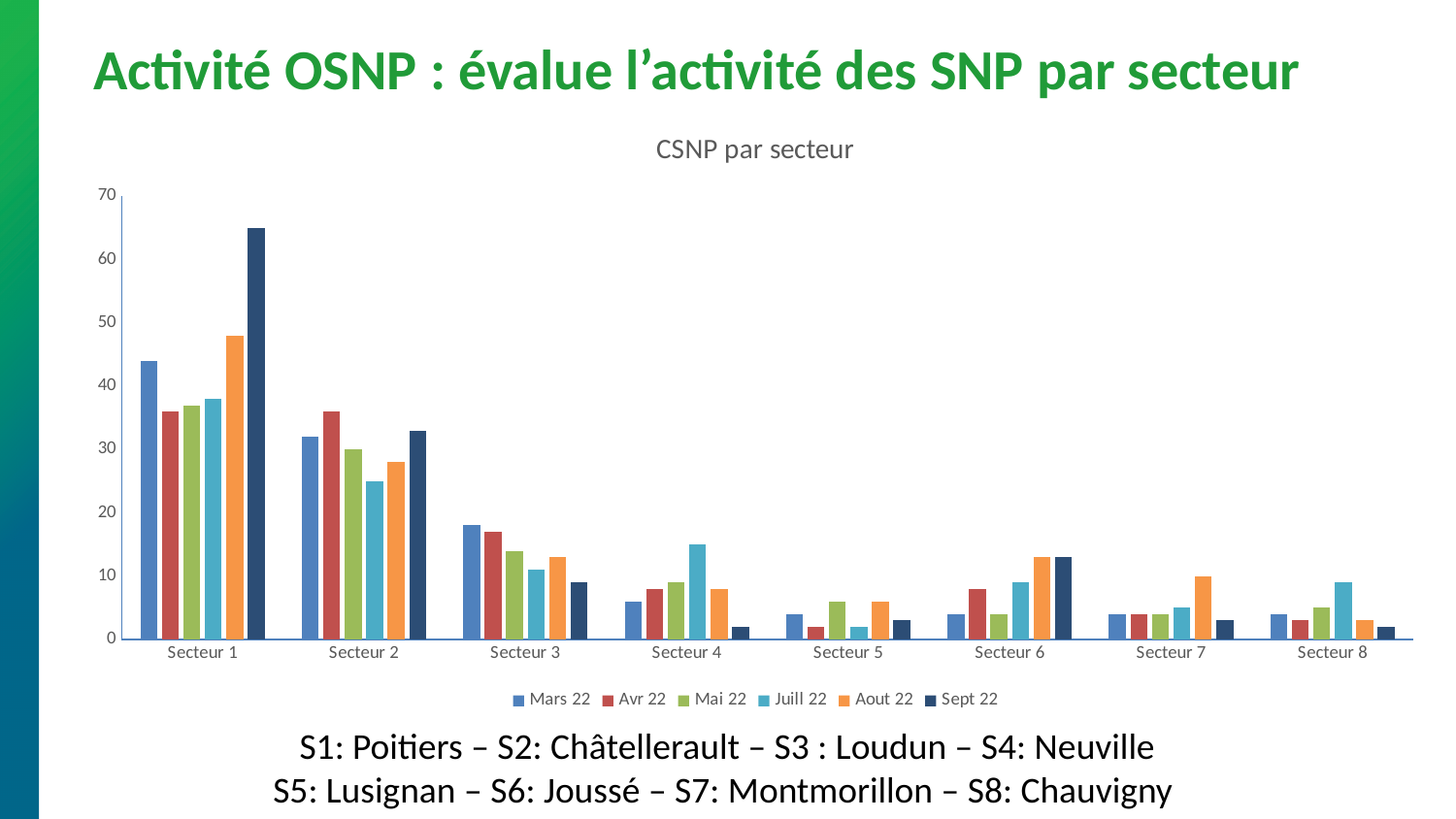
For Secteur 4, which series has the highest value? Juill 22 How many sectors (categories) are shown on the x axis? 8 Is the Mars 22 value for Secteur 1 greater or less than 40? greater What is the title of the chart? CSNP par secteur What kind of chart is shown on the slide? bar chart Which sector has the highest Sept 22 bar? Secteur 1 Is the Sept 22 value for Secteur 1 greater or less than 60? greater Is the Mars 22 value for Secteur 3 greater or less than 20? less How many series does the legend list? 6 For Secteur 1, which is larger: the Sept 22 value or the Aout 22 value? Sept 22 For Secteur 4, which series has the lowest value? Sept 22